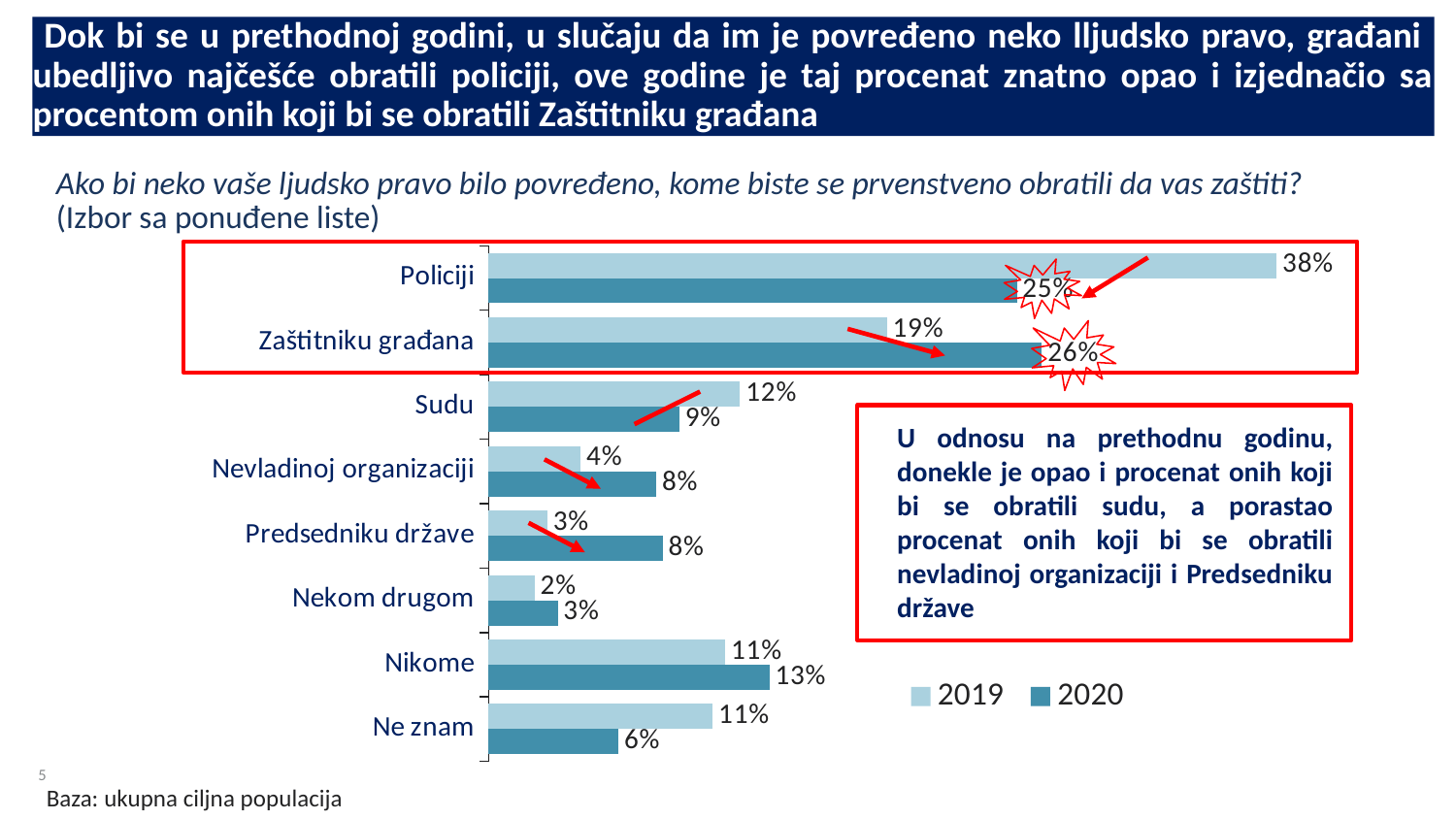
What is the 2020 value for Zaštitniku građana? 26% What is the 2020 value for Nevladinoj organizaciji? 8% Which category has the lowest 2020 value? Nekom drugom Which is larger for Sudu: the 2019 value or the 2020 value? 2019 How many categories are shown on the chart? 8 Which category has the highest 2019 value? Policiji Which series is shown in the darker blue colour? 2020 What kind of chart is shown on the slide? Bar chart What is the 2019 value for Policiji? 38% What is the difference between the 2019 and 2020 values for Policiji? 13% What is the 2019 value for Ne znam? 11% How many series does the legend list? 2